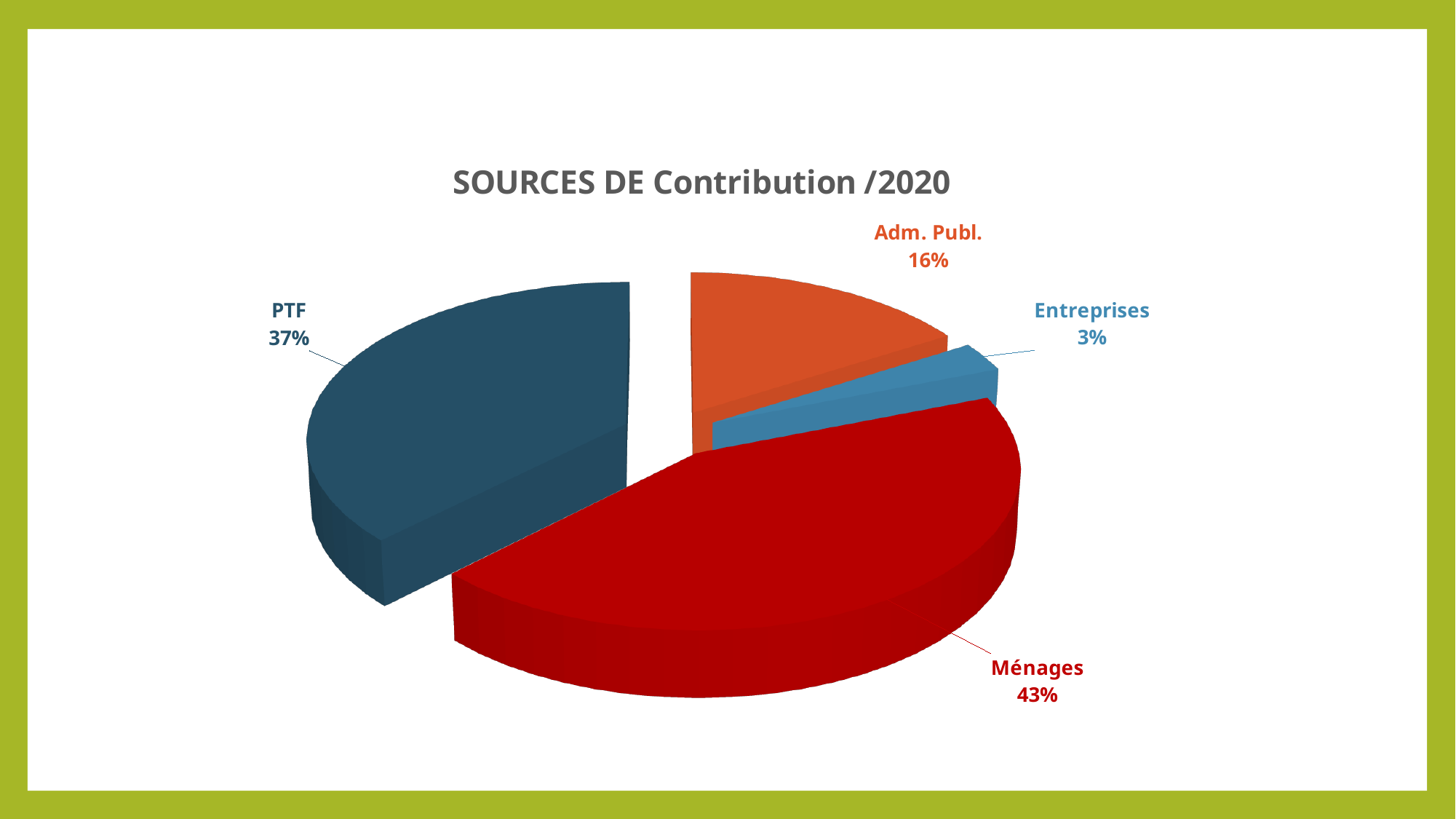
Which is larger, the share for PTF or the share for Adm. Publ.? PTF Which category has the largest share of the pie? Ménages What is the value shown for Entreprises? 3% What kind of chart is shown on the slide? Pie chart What share of the pie does Ménages represent? 43% What is the difference in percentage points between Adm. Publ. and Entreprises? 13 What is the title of the chart? SOURCES DE Contribution /2020 What is the value shown for PTF? 37% What is the difference in percentage points between Ménages and PTF? 6 What is the value shown for Adm. Publ.? 16% How many categories are shown in the pie chart? 4 Which category has the smallest share of the pie? Entreprises